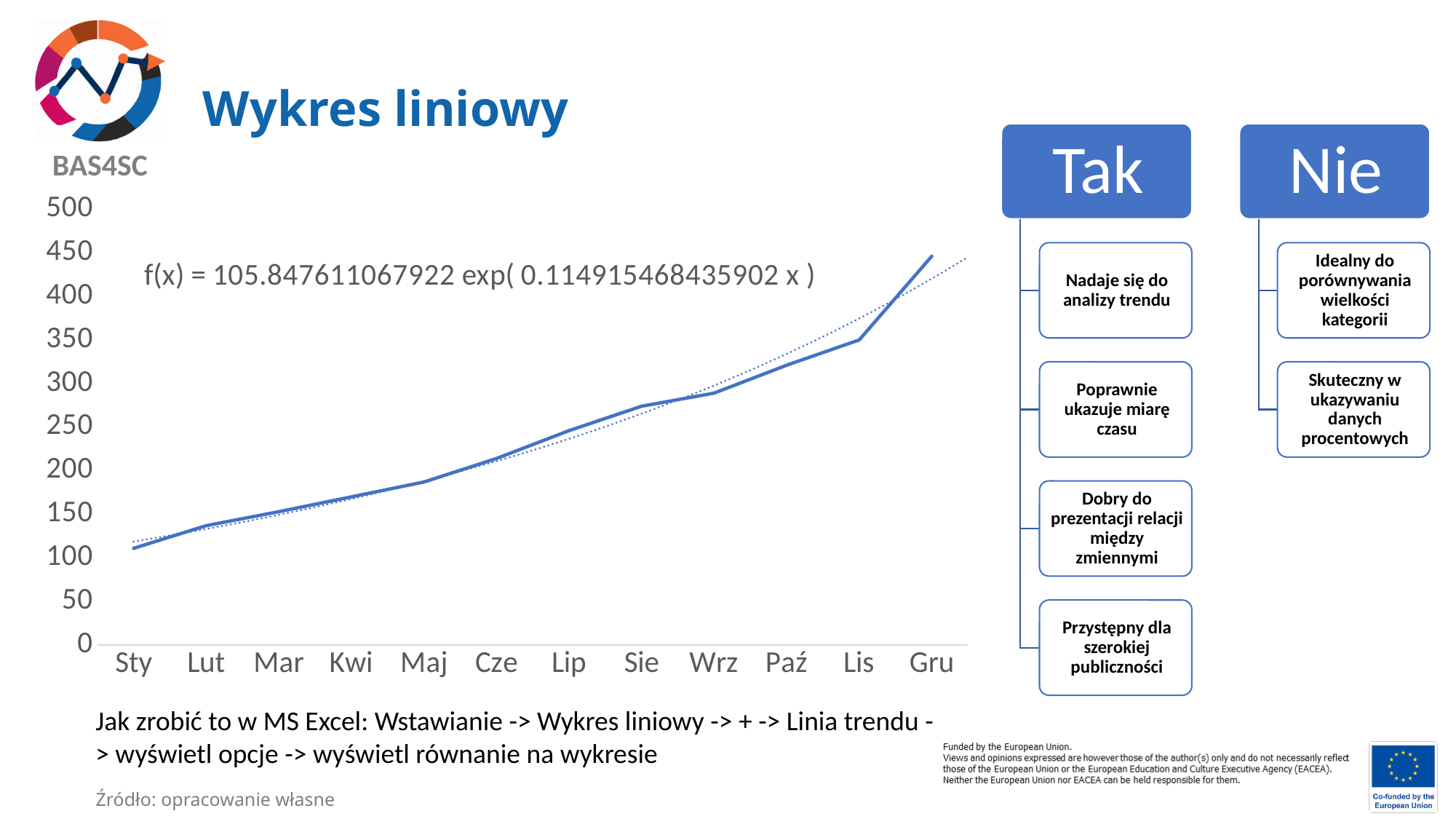
Is the value for Sty greater or less than 150? less What kind of chart is shown on the slide? line chart Which is larger, the value for Sie or the value for Kwi? Sie How many months are shown on the x axis of the chart? 12 What is the highest tick value shown on the y axis? 500 What is the trendline equation displayed on the chart? f(x) = 105.847611067922 exp( 0.114915468435902 x ) Is the value for Lis greater or less than 300? greater Which month has the lowest value? Sty Is the value for Maj greater or less than 200? less Do the values rise or fall from Sty to Gru? rise Which month has the highest value? Gru